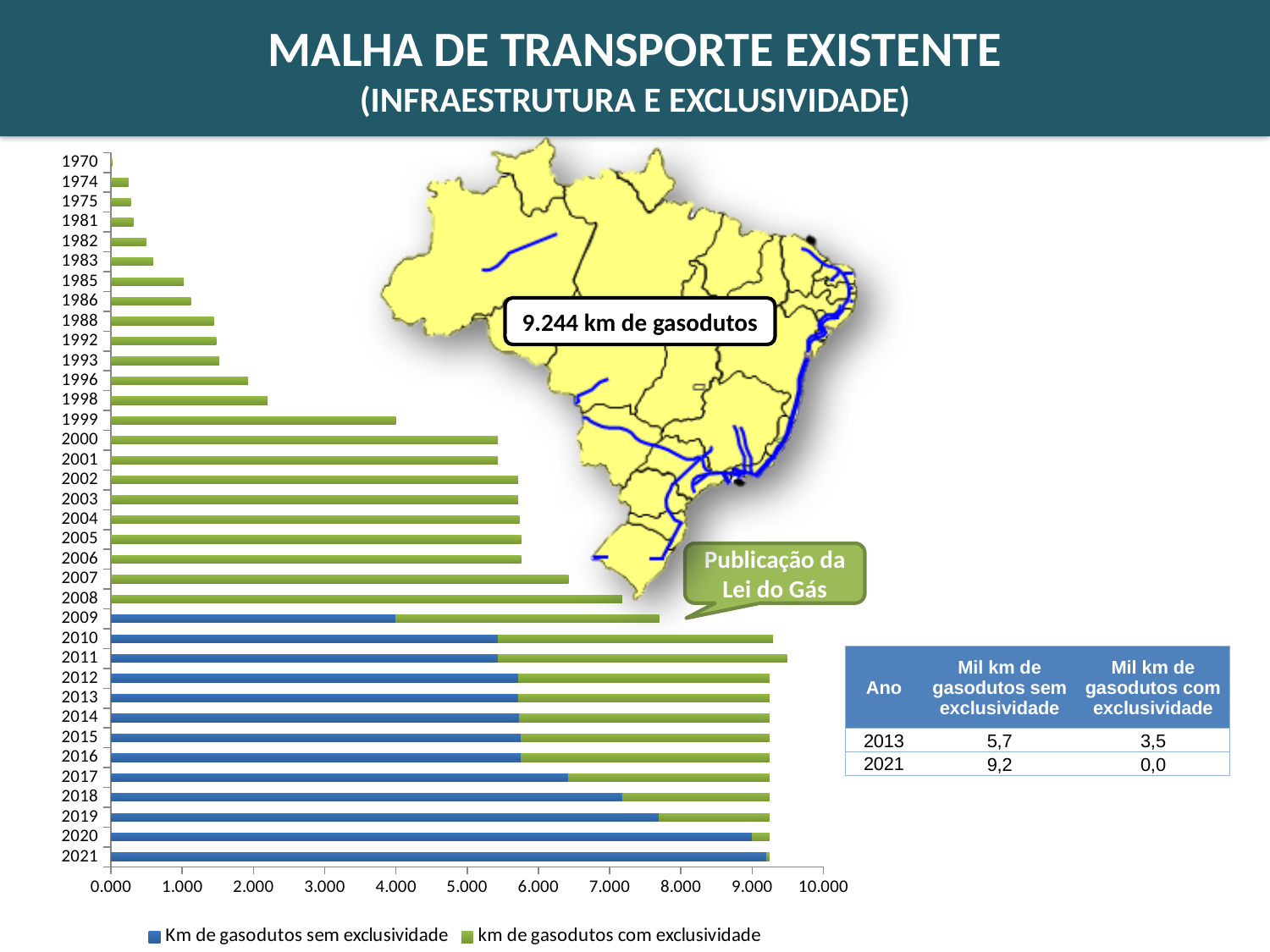
Is the value for 2008 (km de gasodutos com exclusividade) greater or less than 7.000? greater Which is larger: the Km de gasodutos sem exclusividade for 2009 or for 2021? 2021 Which colour represents 'Km de gasodutos sem exclusividade' in the chart? Blue Which year has the shortest bar on the chart? 1970 How many years (categories) are plotted on the chart's vertical axis? 36 Is the value for 2021 (Km de gasodutos sem exclusividade) greater or less than 9.000? greater Is the value for 1998 (km de gasodutos com exclusividade) greater or less than 2.000? greater How many series does the chart legend list? 2 In which year does the blue series (Km de gasodutos sem exclusividade) first appear on the chart? 2009 What kind of chart is shown on the slide? Stacked horizontal bar chart Overall, does the total length of gas pipelines rise or fall from 1970 to 2021? rise